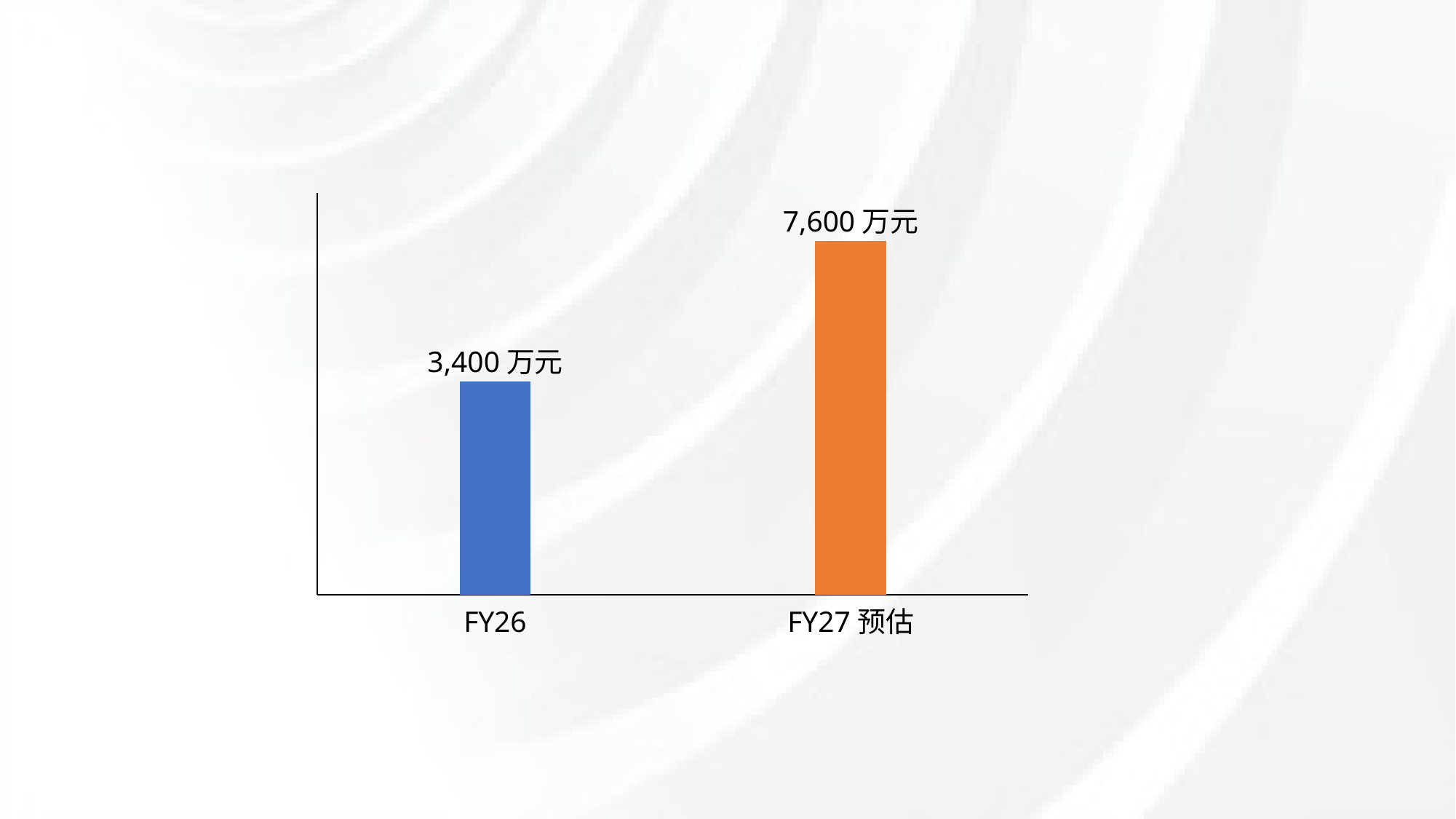
Which category has the lowest value? FY26 How many categories are shown on the x axis? 2 Which is larger, the value for FY26 or the value for FY27 预估? FY27 预估 What is the difference between the FY27 预估 value and the FY26 value? 4,200 万元 What is the value for FY26? 3,400 万元 What is the value for FY27 预估? 7,600 万元 What kind of chart is shown on the slide? Bar chart What colour is the bar for FY27 预估? Orange Which category has the highest value? FY27 预估 Do the values rise or fall from FY26 to FY27 预估? Rise What colour is the bar for FY26? Blue